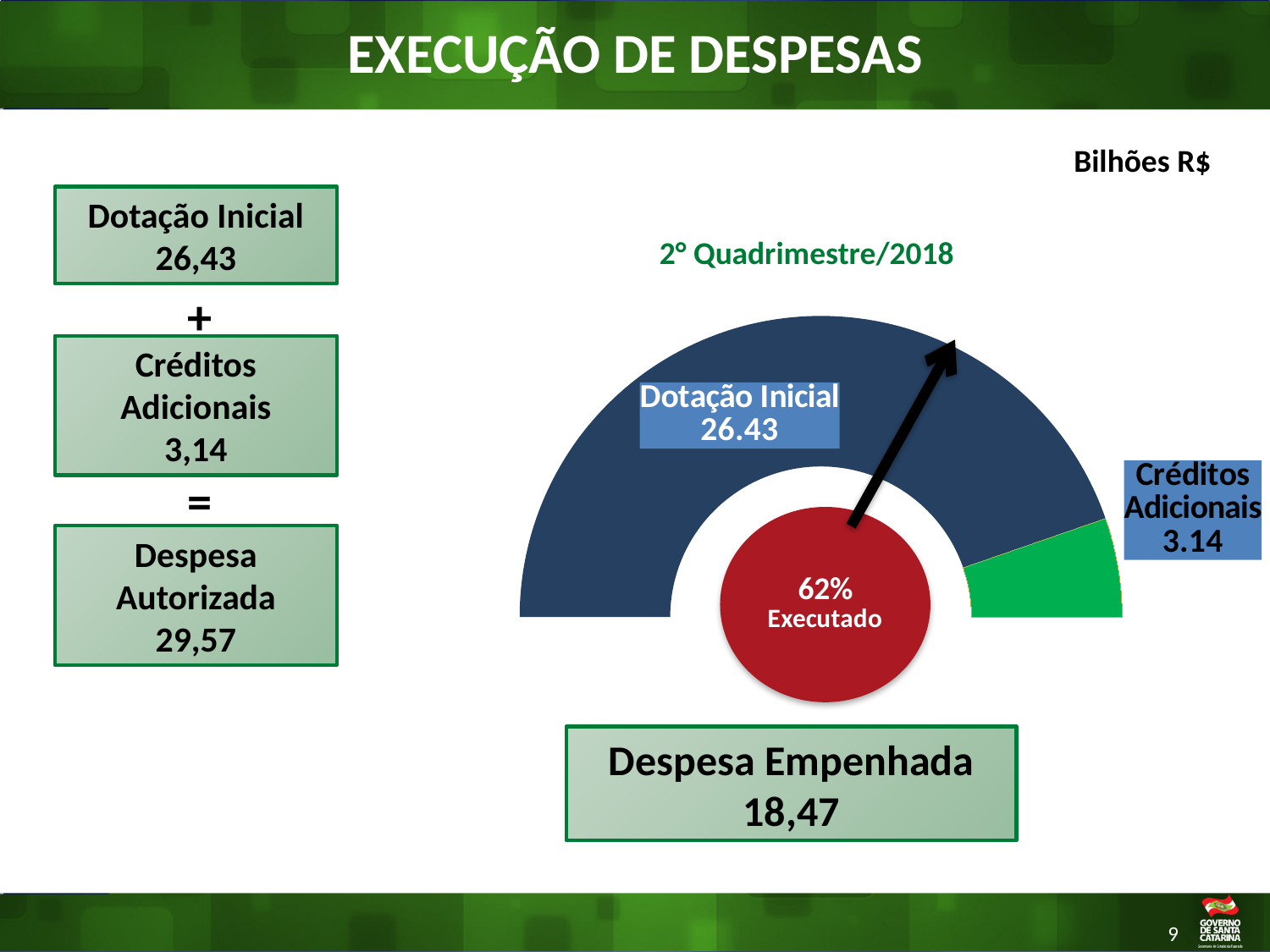
What is the combined total of the two segments of the gauge chart (Dotação Inicial plus Créditos Adicionais)? 29.57 What is the title shown above the gauge chart? 2° Quadrimestre/2018 How many labelled segments make up the gauge chart? 2 What colour is the Créditos Adicionais segment of the gauge chart? Green What value is shown for Dotação Inicial on the gauge chart? 26.43 What percentage is shown as executed in the centre of the gauge chart? 62% Which segment of the gauge chart has the smallest value? Créditos Adicionais What is the difference between the Dotação Inicial and Créditos Adicionais values on the gauge chart? 23.29 What value is shown for Créditos Adicionais on the gauge chart? 3.14 Which segment of the gauge chart is larger, Dotação Inicial or Créditos Adicionais? Dotação Inicial What kind of chart is shown on the slide? Gauge (semi-doughnut) chart In what unit are the values on the slide expressed? Bilhões R$